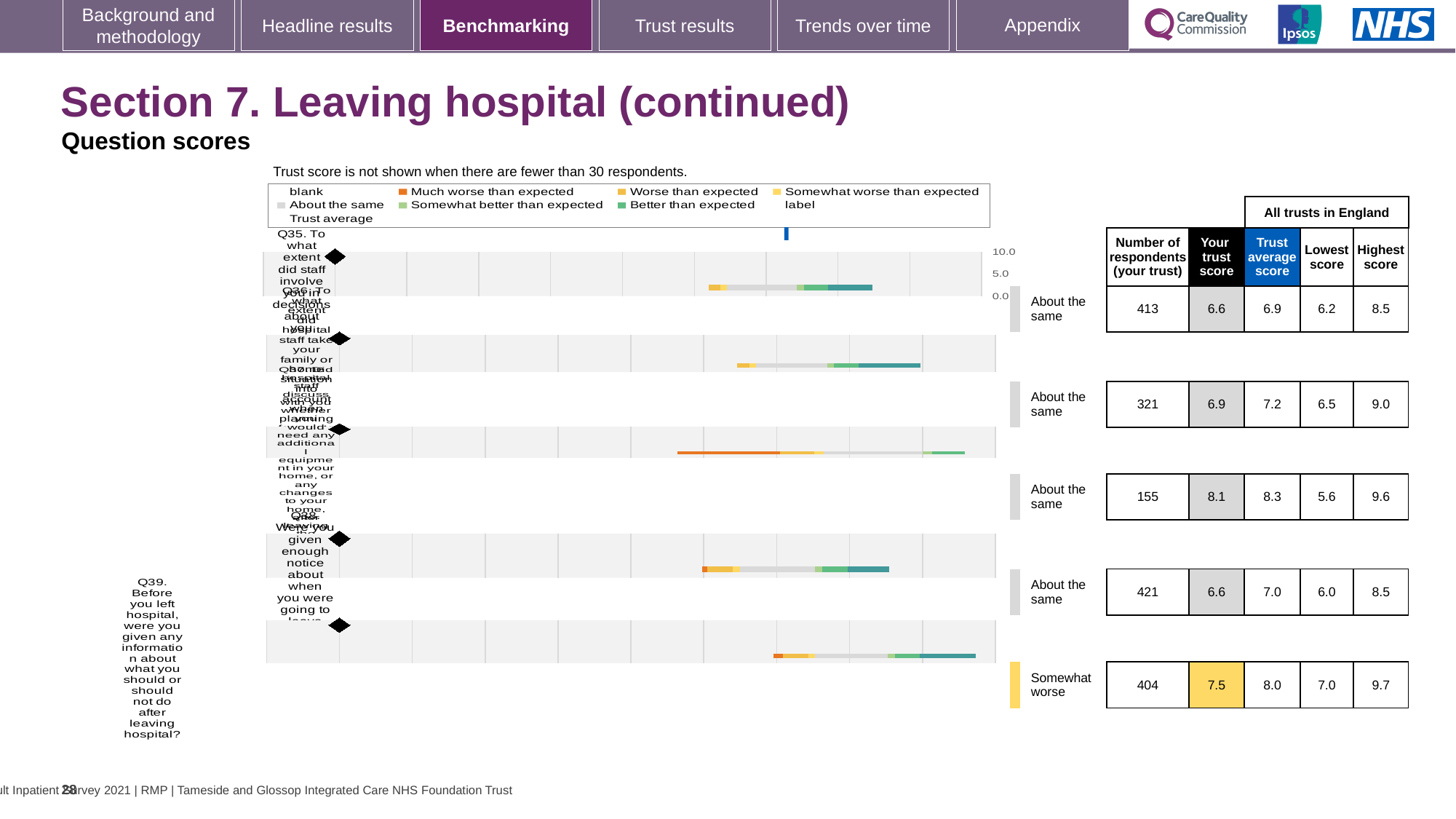
In the table, what is the trust score for Q39 (information about what you should or should not do after leaving hospital)? 7.5 In the table, which question row has the fewest respondents? Q37 (third row), 155 In the table, what is the trust average score for Q39? 8.0 In the table, what is the highest score across all trusts in England for Q39? 9.7 How many question rows are shown in the chart and table? 5 In the table, which question row has the most respondents? Q38 (fourth row), 421 What kind of chart is used to show the benchmarking results? Bar chart What is the difference between the trust average score and the trust score for Q39? 0.5 In the table, which question row has the highest 'Your trust score'? Q37 (third row), 8.1 In the table, what is the trust score for Q35 (the first question row)? 6.6 Which question row is rated 'Somewhat worse' rather than 'About the same'? Q39 (the last row) In the table, how many respondents answered Q39? 404